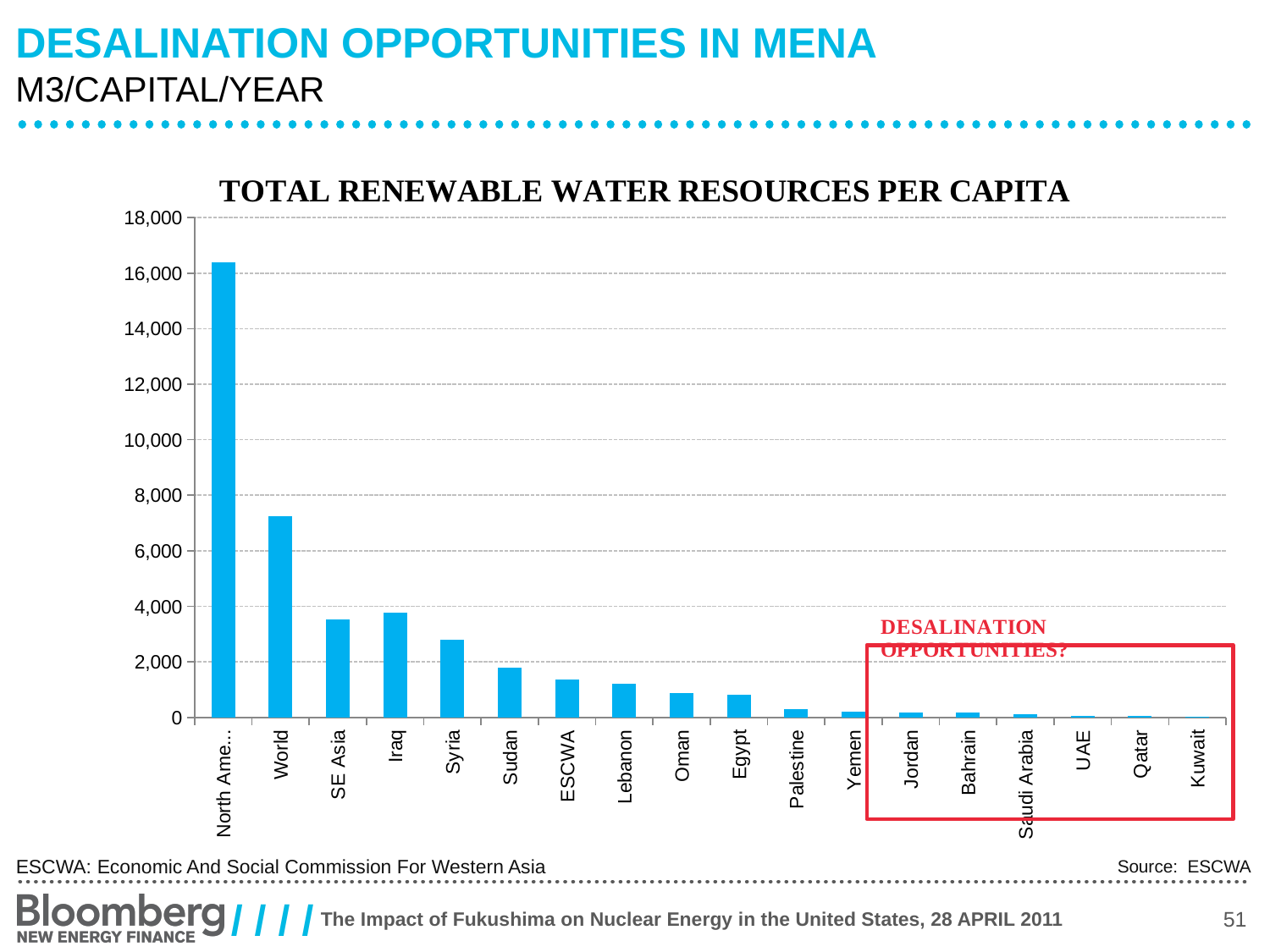
Which has a higher value, Iraq or SE Asia? Iraq Which category has the highest total renewable water resources per capita? North Ame... How many categories are plotted along the x axis of the chart? 18 Which has a higher value, World or Syria? World What kind of chart is shown on the slide? bar chart Is the value for Syria greater or less than 2,000? greater Is the value for North Ame... greater or less than 14,000? greater Do the values generally rise or fall moving from left to right along the x axis? fall What is the title of the chart? TOTAL RENEWABLE WATER RESOURCES PER CAPITA Is the value for Sudan greater or less than 2,000? less